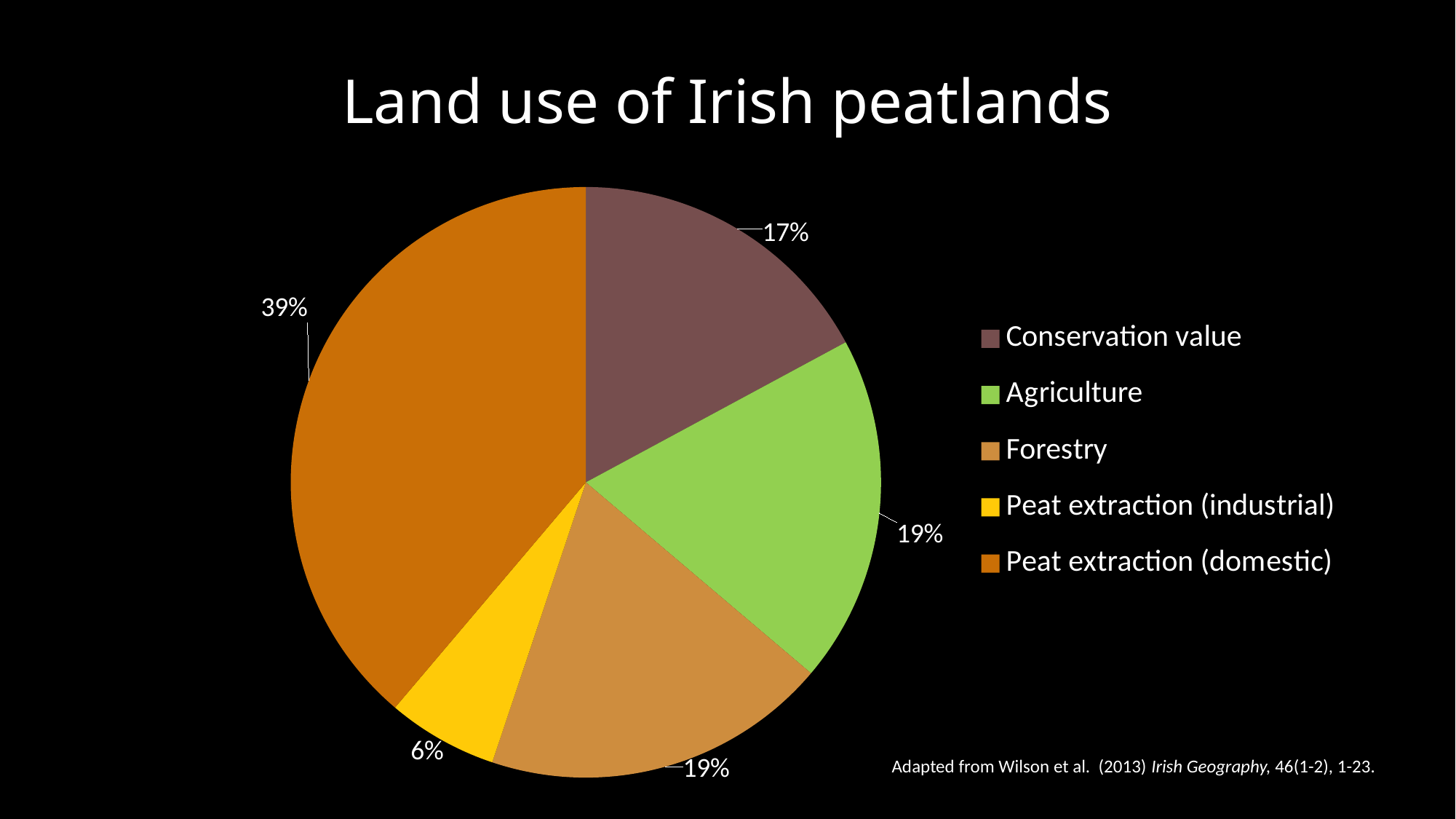
How many categories does the pie chart show? 5 What share of Irish peatlands is used for Agriculture? 19% What is the difference in percentage points between Peat extraction (domestic) and Conservation value? 22 Which land use category has the largest share of the pie? Peat extraction (domestic) What kind of chart is shown on the slide? pie chart What is the title of the chart? Land use of Irish peatlands What share of Irish peatlands is used for Peat extraction (domestic)? 39% What share of Irish peatlands is used for Forestry? 19% Which is larger, the share for Agriculture or the share for Conservation value? Agriculture Which land use category has the smallest share of the pie? Peat extraction (industrial)